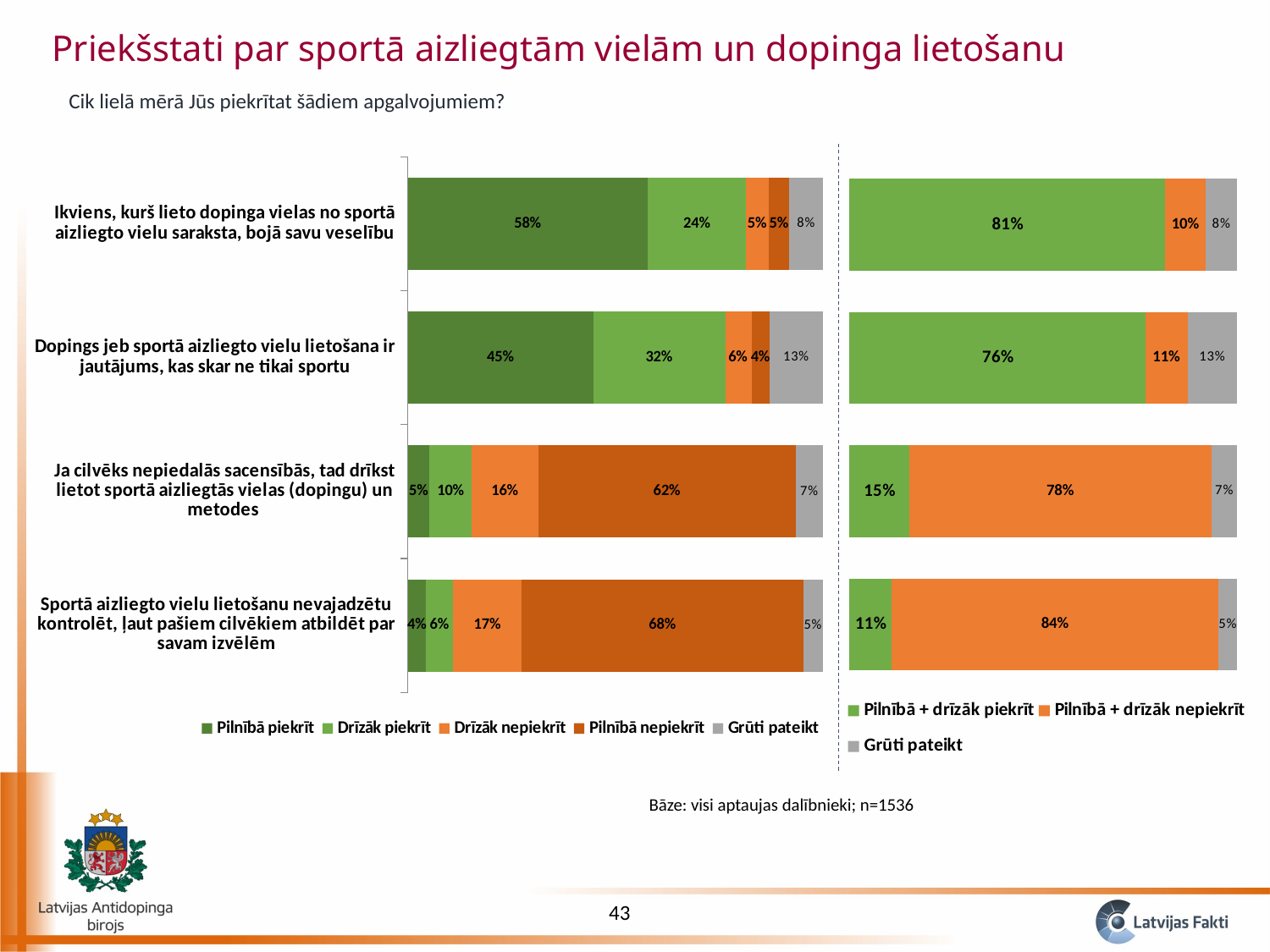
How many series does the legend of the right chart list? 3 In the left chart, what percentage of respondents answered "Pilnībā piekrīt" to the statement "Ikviens, kurš lieto dopinga vielas no sportā aizliegto vielu saraksta, bojā savu veselību"? 58% In the left chart, which is larger for the statement "Ja cilvēks nepiedalās sacensībās, tad drīkst lietot sportā aizliegtās vielas (dopingu) un metodes": "Drīzāk nepiekrīt" or "Pilnībā nepiekrīt"? Pilnībā nepiekrīt How many statements (categories) are shown in the left chart? 4 In the left chart, what is the "Pilnībā nepiekrīt" value for the statement "Sportā aizliegto vielu lietošanu nevajadzētu kontrolēt, ļaut pašiem cilvēkiem atbildēt par savam izvēlēm"? 68% In the left chart, which statement has the lowest "Grūti pateikt" value? Sportā aizliegto vielu lietošanu nevajadzētu kontrolēt, ļaut pašiem cilvēkiem atbildēt par savam izvēlēm How many series does the legend of the left chart list? 5 In the right chart, what is the "Pilnībā + drīzāk piekrīt" value for the statement "Dopings jeb sportā aizliegto vielu lietošana ir jautājums, kas skar ne tikai sportu"? 76% In the left chart, what is the total of the "Pilnībā piekrīt" and "Drīzāk piekrīt" segments for the statement "Dopings jeb sportā aizliegto vielu lietošana ir jautājums, kas skar ne tikai sportu"? 77% In the right chart, what is the difference between the "Pilnībā + drīzāk piekrīt" values for the first statement (81%) and the second statement (76%)? 5 percentage points What type of chart is the right chart? Stacked horizontal bar chart In the right chart, which statement has the highest "Pilnībā + drīzāk nepiekrīt" value? Sportā aizliegto vielu lietošanu nevajadzētu kontrolēt, ļaut pašiem cilvēkiem atbildēt par savam izvēlēm